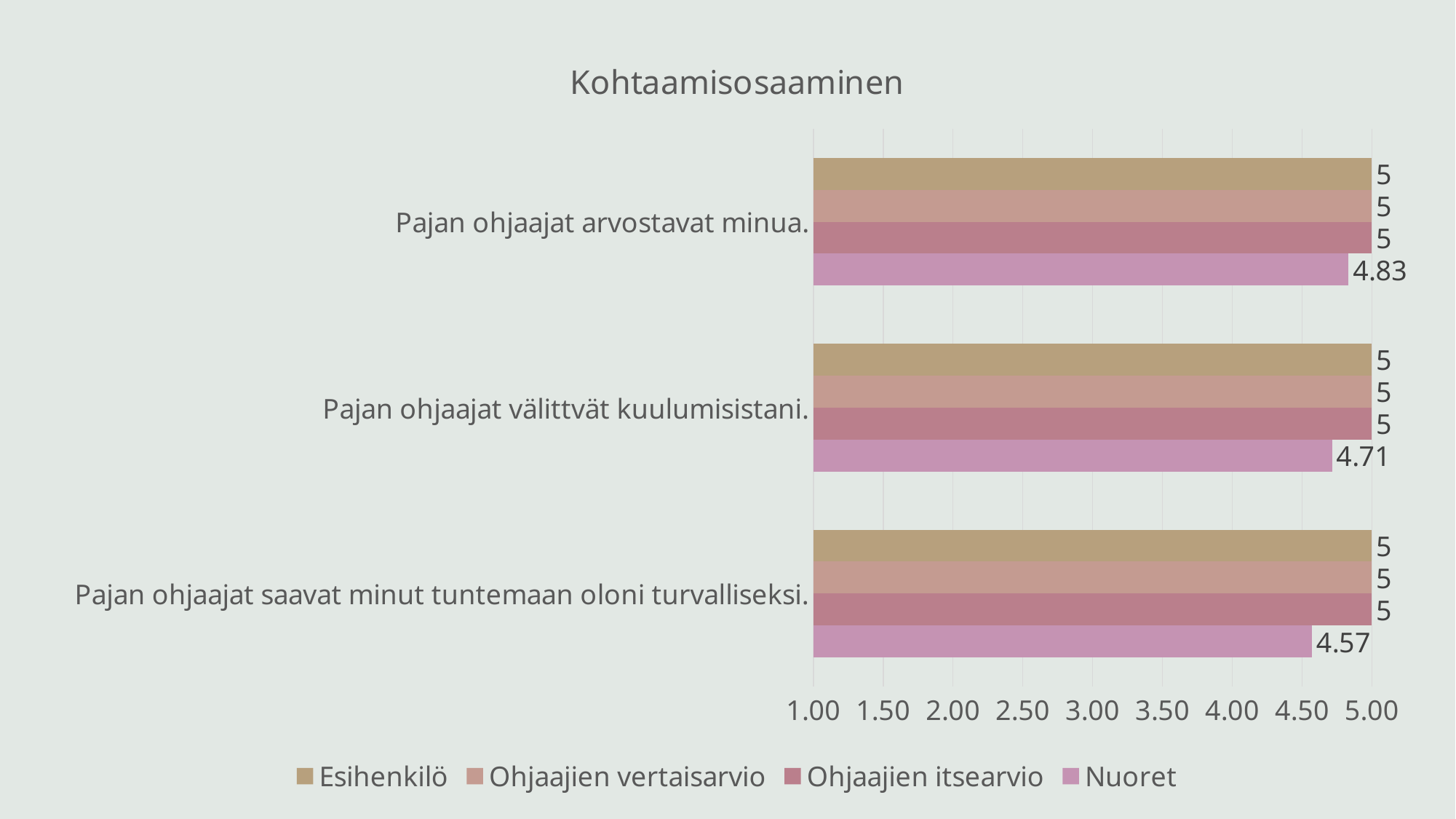
Which is larger for 'Pajan ohjaajat välittvät kuulumisistani.': the Ohjaajien itsearvio value or the Nuoret value? Ohjaajien itsearvio What is the value for Nuoret for 'Pajan ohjaajat saavat minut tuntemaan oloni turvalliseksi.'? 4.57 What is the value for Nuoret for 'Pajan ohjaajat arvostavat minua.'? 4.83 How many series does the legend list? 4 What is the difference between the Nuoret values for 'Pajan ohjaajat arvostavat minua.' and 'Pajan ohjaajat saavat minut tuntemaan oloni turvalliseksi.'? 0.26 How many categories are shown on the chart? 3 What is the title of the chart? Kohtaamisosaaminen What is the value for Nuoret for 'Pajan ohjaajat välittvät kuulumisistani.'? 4.71 Which category has the lowest Nuoret value? Pajan ohjaajat saavat minut tuntemaan oloni turvalliseksi. Which category has the highest Nuoret value? Pajan ohjaajat arvostavat minua. What is the value for Esihenkilö for 'Pajan ohjaajat arvostavat minua.'? 5 What kind of chart is shown on the slide? Bar chart